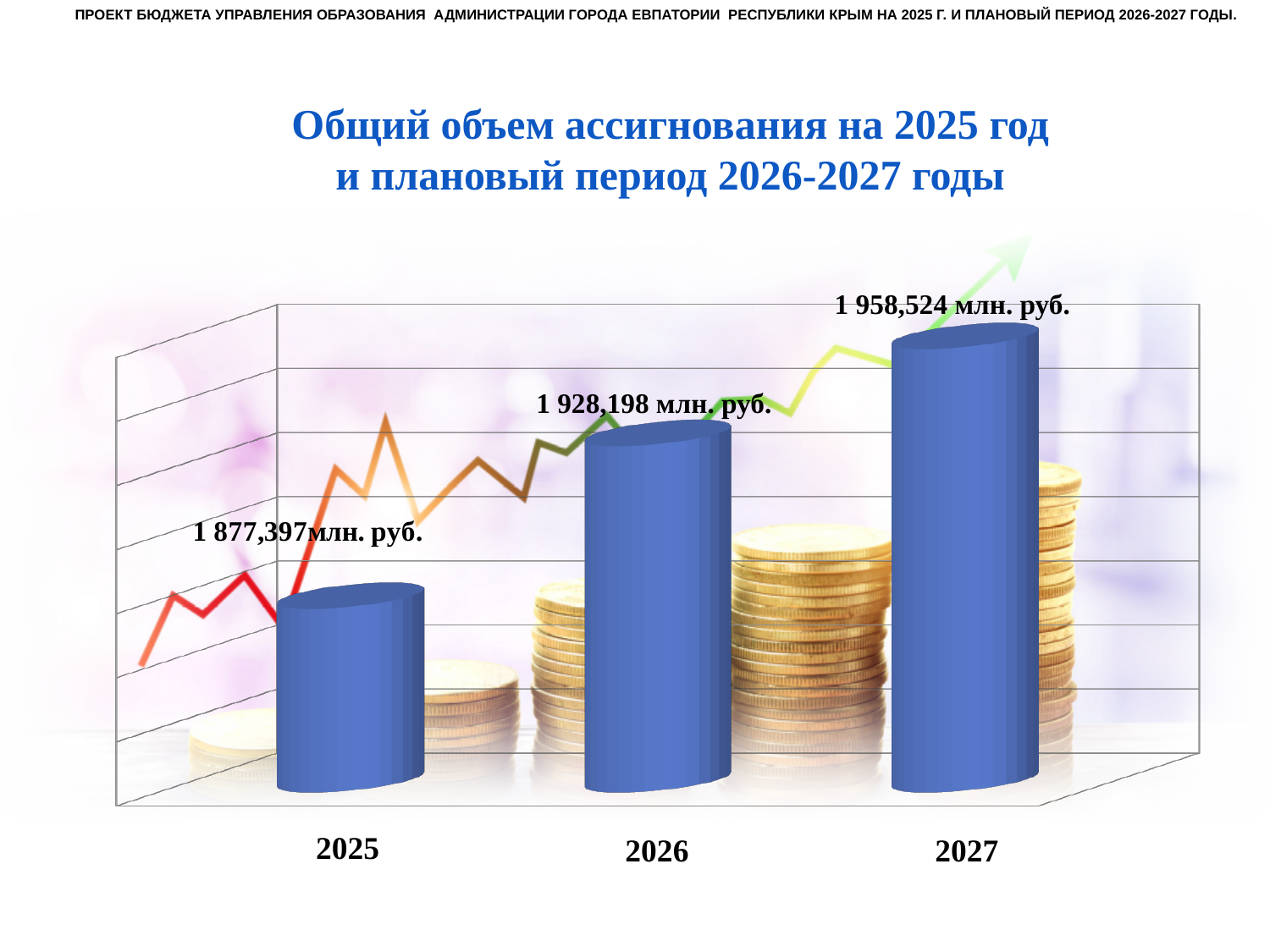
Which year has the lowest value? 2025 What is the value shown for 2025? 1 877,397 млн. руб. What is the value shown for 2027? 1 958,524 млн. руб. What is the title of the chart? Общий объем ассигнования на 2025 год и плановый период 2026-2027 годы Which year has the highest value? 2027 How many years are shown on the chart? 3 Do the values rise or fall from 2025 to 2027? Rise What kind of chart is shown on the slide? Bar chart What is the difference between the values for 2026 and 2025? 50,801 млн. руб. What is the difference between the values for 2027 and 2026? 30,326 млн. руб. Which is larger, the value for 2026 or the value for 2025? 2026 What is the value shown for 2026? 1 928,198 млн. руб.